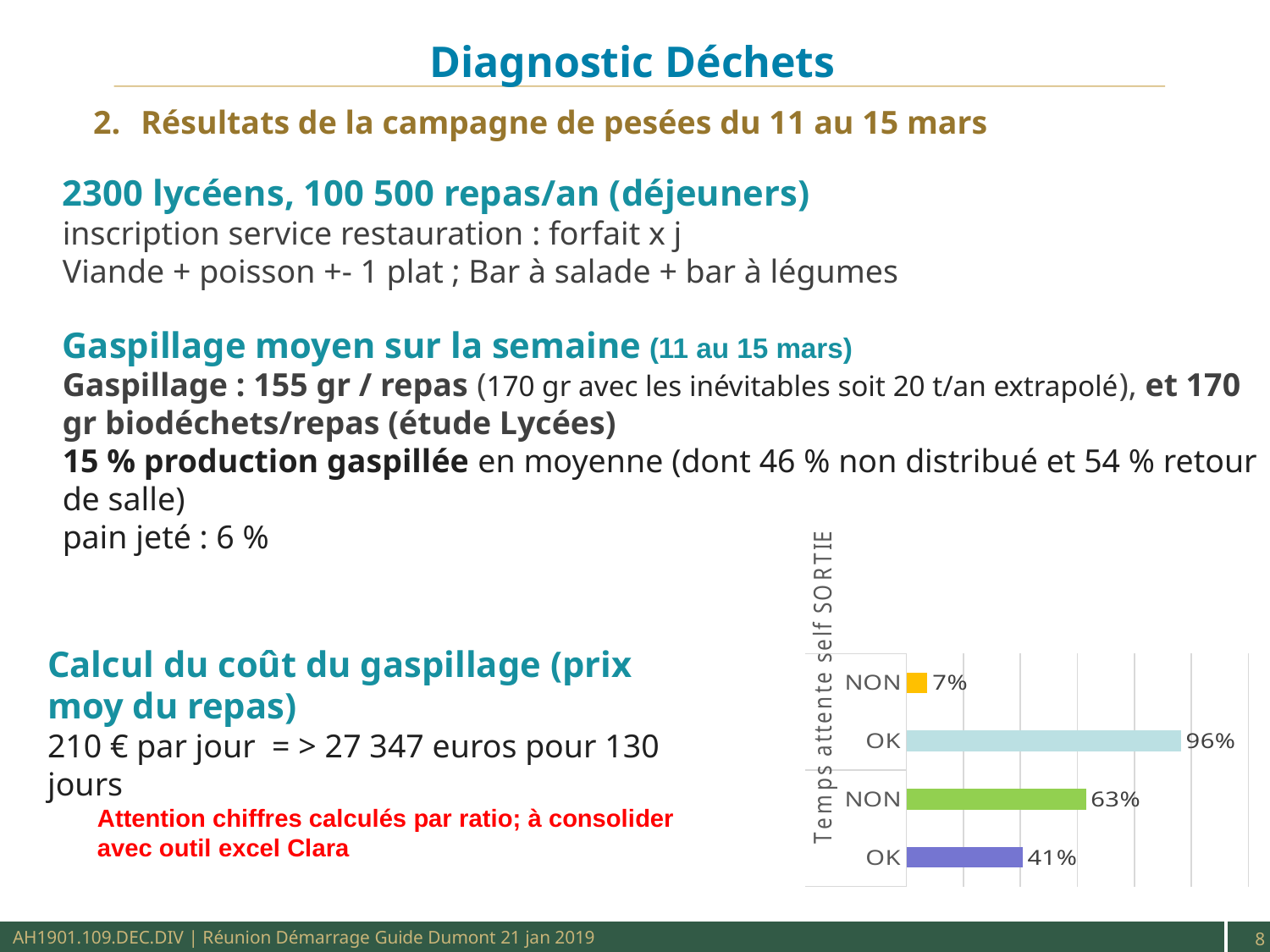
Which bar has the highest value in the chart? the second bar from the top (OK, 96%) What is the value of the second bar from the top (labelled OK) in the chart? 96% What kind of chart is shown on the slide? bar chart How many bars are plotted in the chart? 4 Which is larger in the chart: the third bar from the top (NON, 63%) or the bottom bar (OK, 41%)? the third bar from the top (NON, 63%) What is the text of the vertical axis title of the chart? Temps attente self SORTIE Which bar has the lowest value in the chart? the topmost bar (NON, 7%) What is the difference between the two OK bars (96% and 41%) in the chart? 55% What is the value of the topmost bar (labelled NON) in the chart? 7% What is the value of the bottom bar (labelled OK) in the chart? 41% What is the difference between the two NON bars (63% and 7%) in the chart? 56% What is the value of the third bar from the top (labelled NON) in the chart? 63%